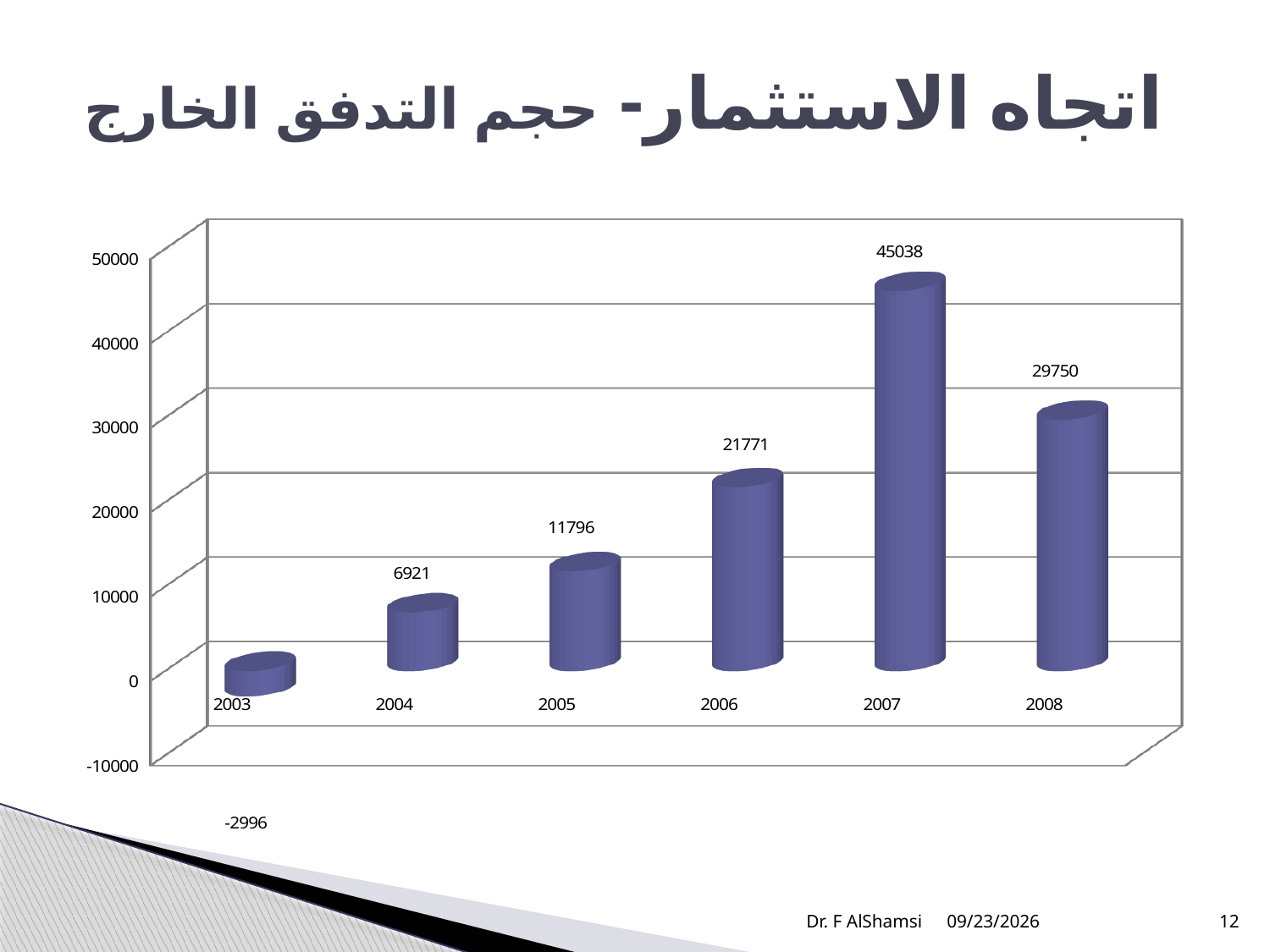
What is the difference between the values for 2006 and 2005? 9975 What is the difference between the values for 2007 and 2008? 15288 Which year has the highest value? 2007 What is the value for 2003? -2996 Which is larger, the value for 2004 or the value for 2006? 2006 What is the value for 2005? 11796 What kind of chart is shown on the slide? bar chart Which year has the lowest value? 2003 What is the value for 2007? 45038 Is the value for 2006 greater or less than 20000? greater How many years are shown on the x axis? 6 What is the value for 2008? 29750